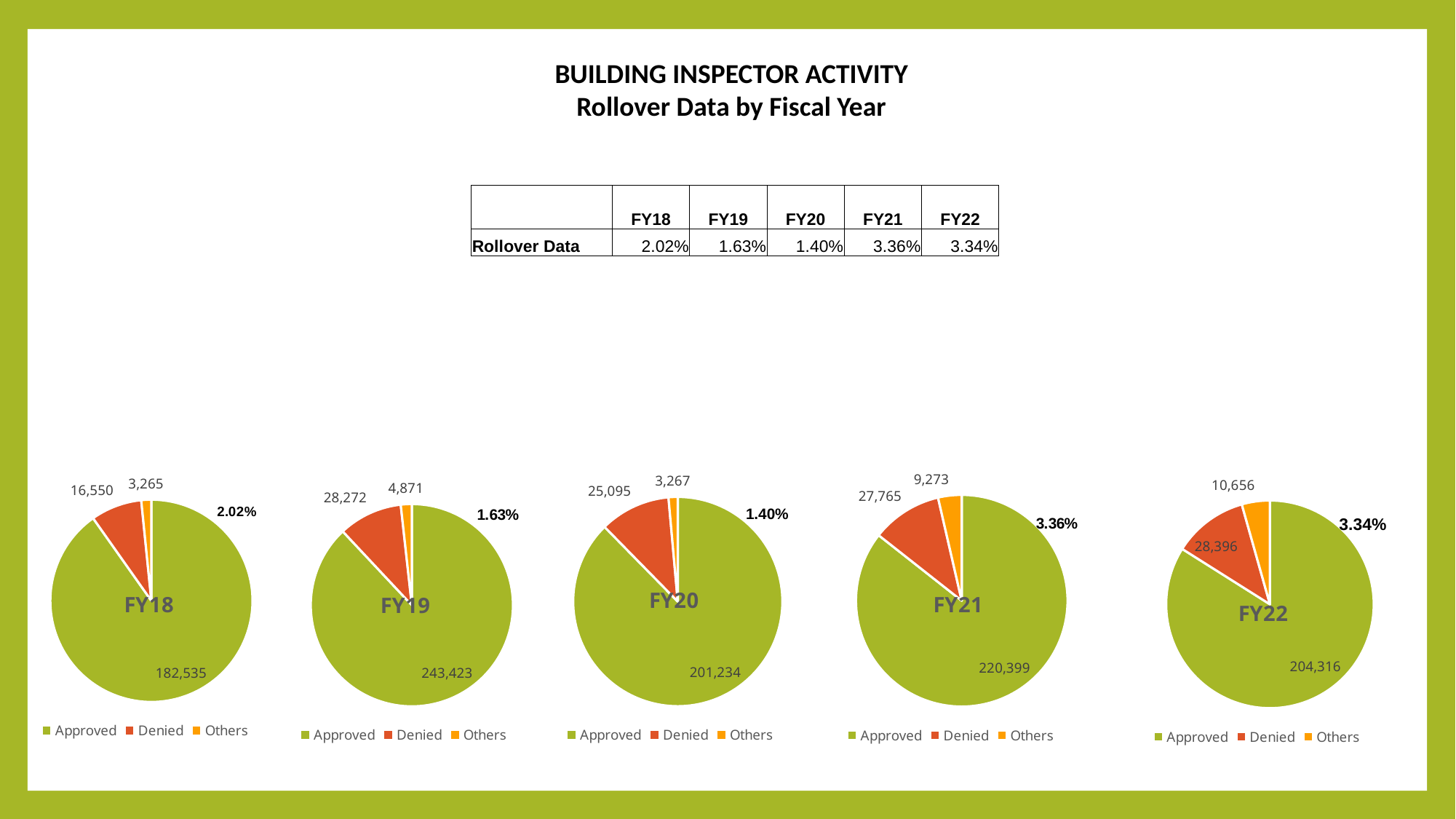
How many pie charts are shown on the slide? 5 How many slices does the FY21 pie chart have? 3 What kind of chart is used for FY18? Pie chart Which is larger: the Denied value in the FY19 pie chart or the Denied value in the FY20 pie chart? FY19 Denied (28,272) In the FY20 pie chart, what is the value for Others? 3,267 In the FY21 pie chart, what is the value for Approved? 220,399 In the FY20 pie chart, which category has the largest slice? Approved In the FY22 pie chart, which category has the smallest slice? Others In the FY22 pie chart, what is the value for Denied? 28,396 In the FY18 pie chart, what is the value for Approved? 182,535 In the FY18 pie chart, what is the difference between the Denied value and the Others value? 13,285 In the FY19 pie chart, what is the value for Denied? 28,272